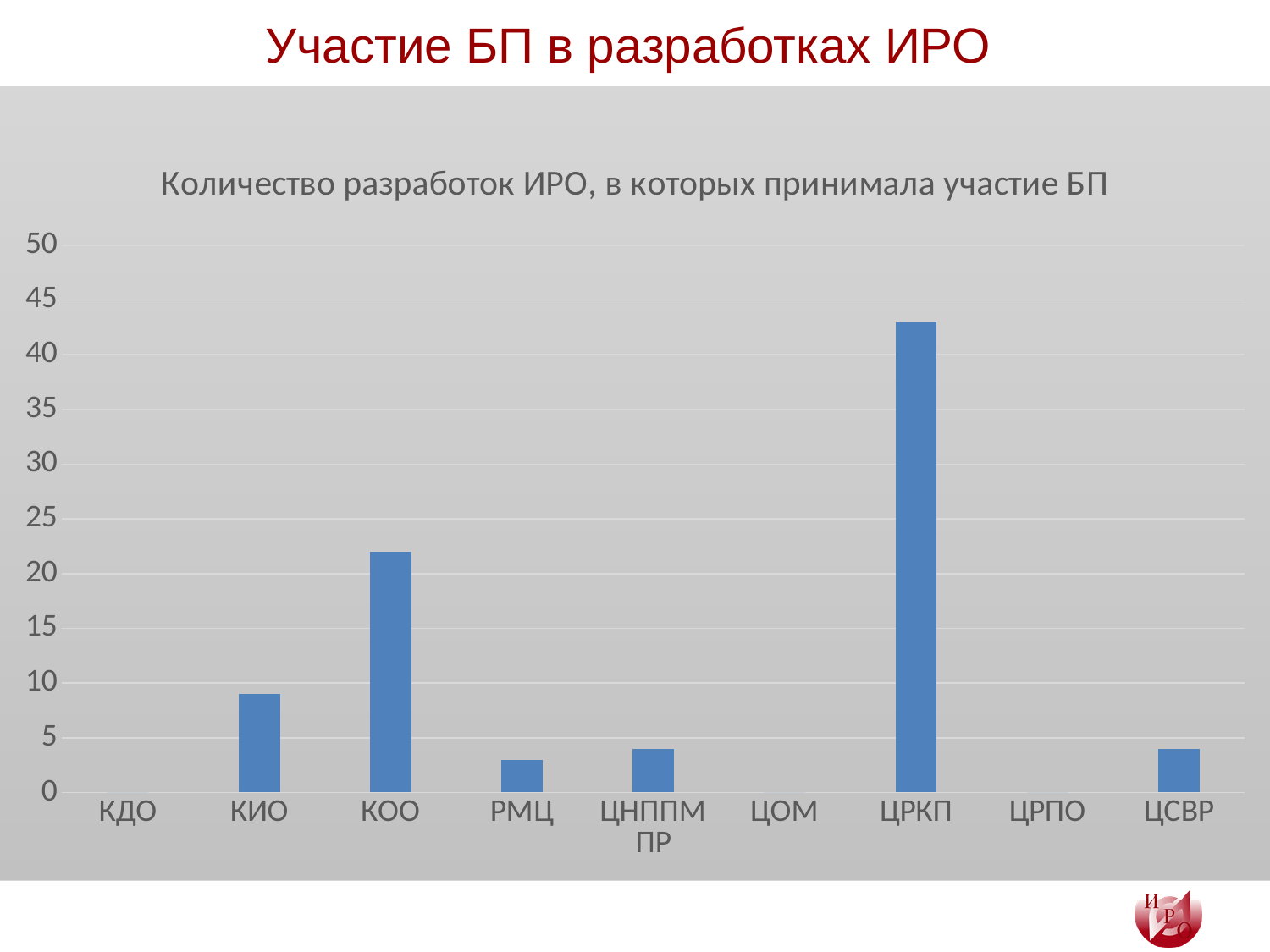
Which category has the highest value in the chart? ЦРКП Is the value for ЦРКП greater or less than 40? greater Which is larger, the value for ЦРКП or the value for КОО? ЦРКП How many categories are shown on the x axis of the chart? 9 Which is larger, the value for КОО or the value for КИО? КОО Is the value for КОО greater or less than 20? greater Is the value for КИО greater or less than 15? less What kind of chart is shown on the slide? bar chart What is the title of the chart? Количество разработок ИРО, в которых принимала участие БП How many categories in the chart have no visible bar? 3